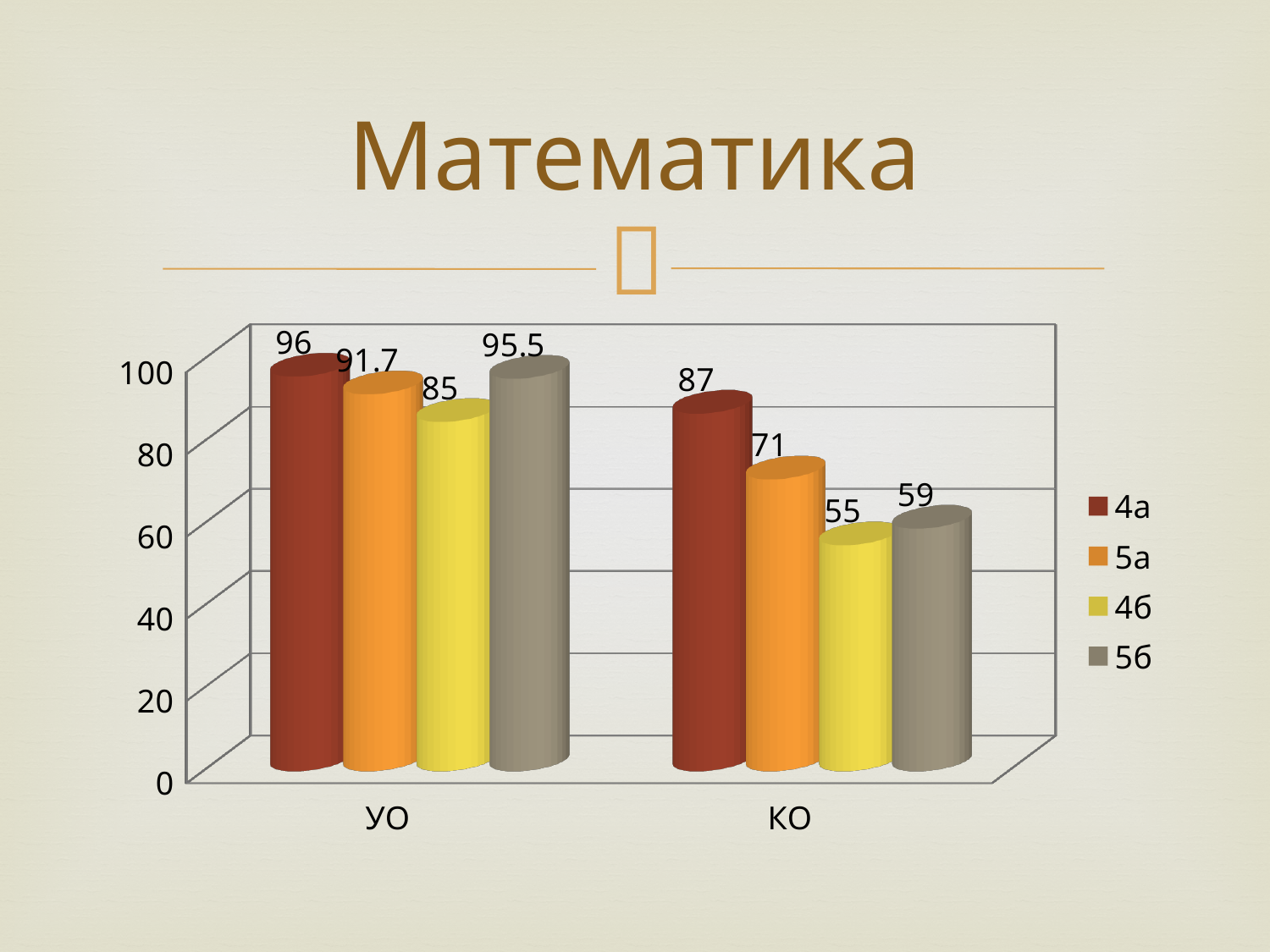
Which series has the highest value in the КО category? 4а What is the value for 4б in the УО category? 85 Which is larger: the 5а value for УО or the 5б value for УО? 5б value for УО Do the values for 5а rise or fall from УО to КО? fall Which series has the lowest value in the УО category? 4б What is the title of the slide? Математика What is the difference between the 4а values for УО and КО? 9 What kind of chart is shown on the slide? bar chart What is the value for 5б in the КО category? 59 How many categories are shown on the x axis? 2 What is the value for 4а in the УО category? 96 How many series does the legend list? 4